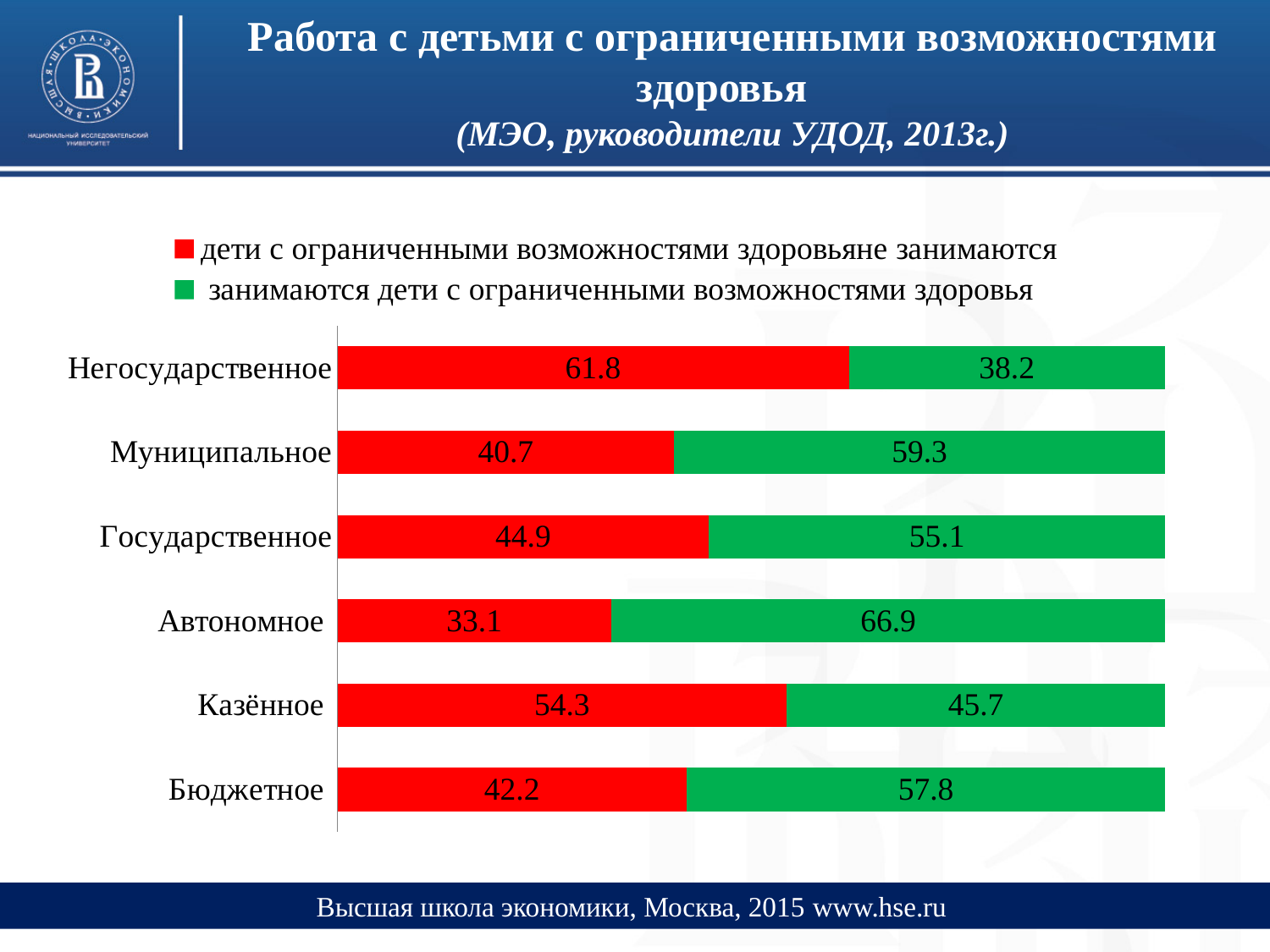
Which category has the highest value for 'занимаются дети с ограниченными возможностями здоровья'? Автономное Which category has the lowest value for 'дети с ограниченными возможностями здоровья не занимаются'? Автономное How many categories are shown on the chart? 6 What is the value for 'дети с ограниченными возможностями здоровья не занимаются' for Негосударственное? 61.8 What is the value for 'занимаются дети с ограниченными возможностями здоровья' for Автономное? 66.9 Which colour represents 'занимаются дети с ограниченными возможностями здоровья' in the legend? Green What kind of chart is shown on the slide? Stacked bar chart Which is larger: the 'занимаются' value for Государственное or for Казённое? Государственное How many series does the legend list? 2 What is the total of the stacked bar for Казённое? 100 What is the value for 'занимаются дети с ограниченными возможностями здоровья' for Бюджетное? 57.8 What is the difference between the 'не занимаются' values for Негосударственное and Муниципальное? 21.1